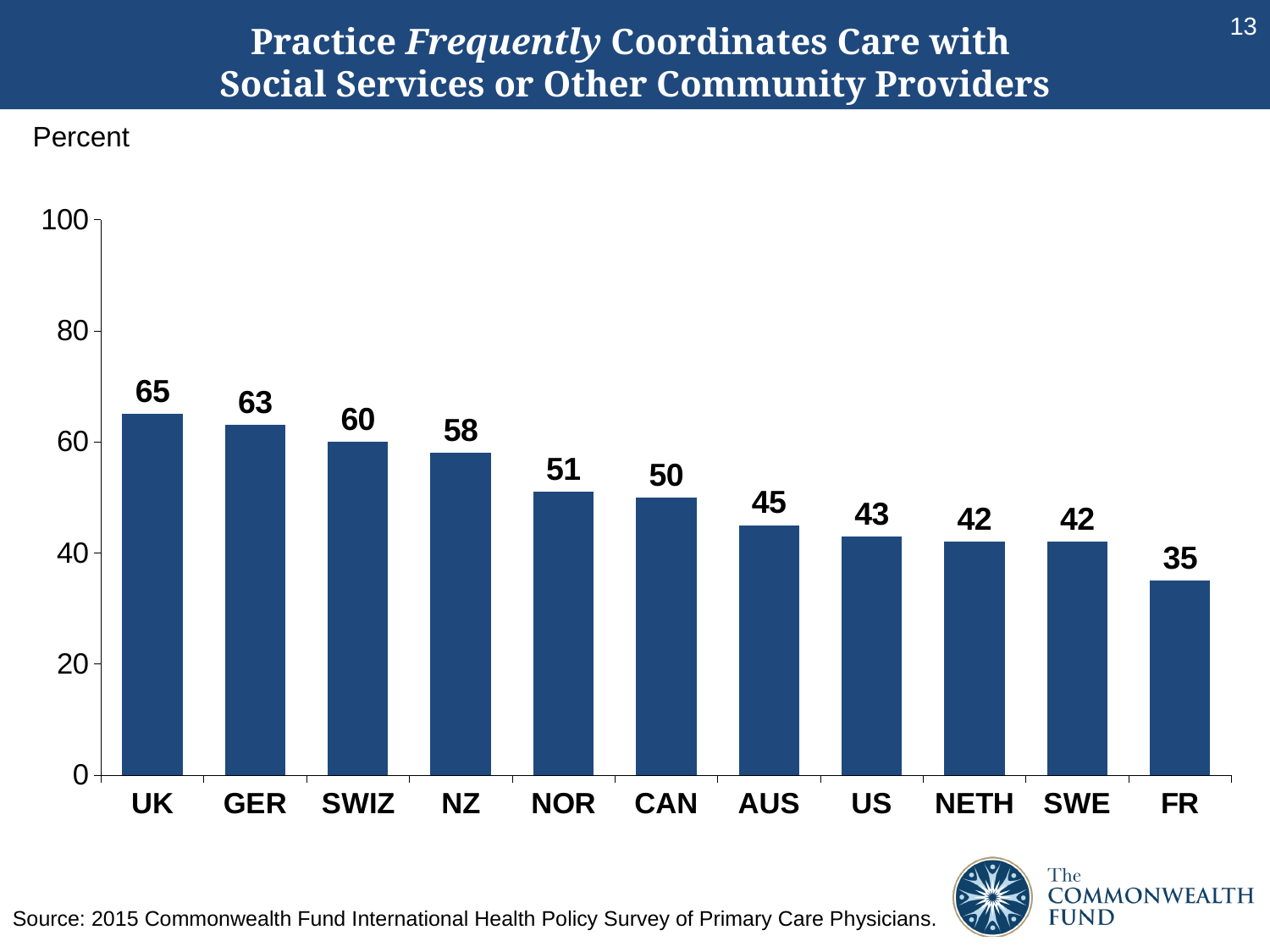
What kind of chart is shown on the slide? bar chart Do the values rise or fall from left to right across the countries? fall Which is larger, the value for SWIZ or the value for AUS? SWIZ What is the value for FR? 35 How many countries are shown on the chart? 11 What is the value for NOR? 51 What is the difference between the values for GER and CAN? 13 Is the value for NZ greater or less than 40? greater Which country has the highest value? UK Which country has the lowest value? FR What is the value for the UK? 65 What is the difference between the values for UK and FR? 30